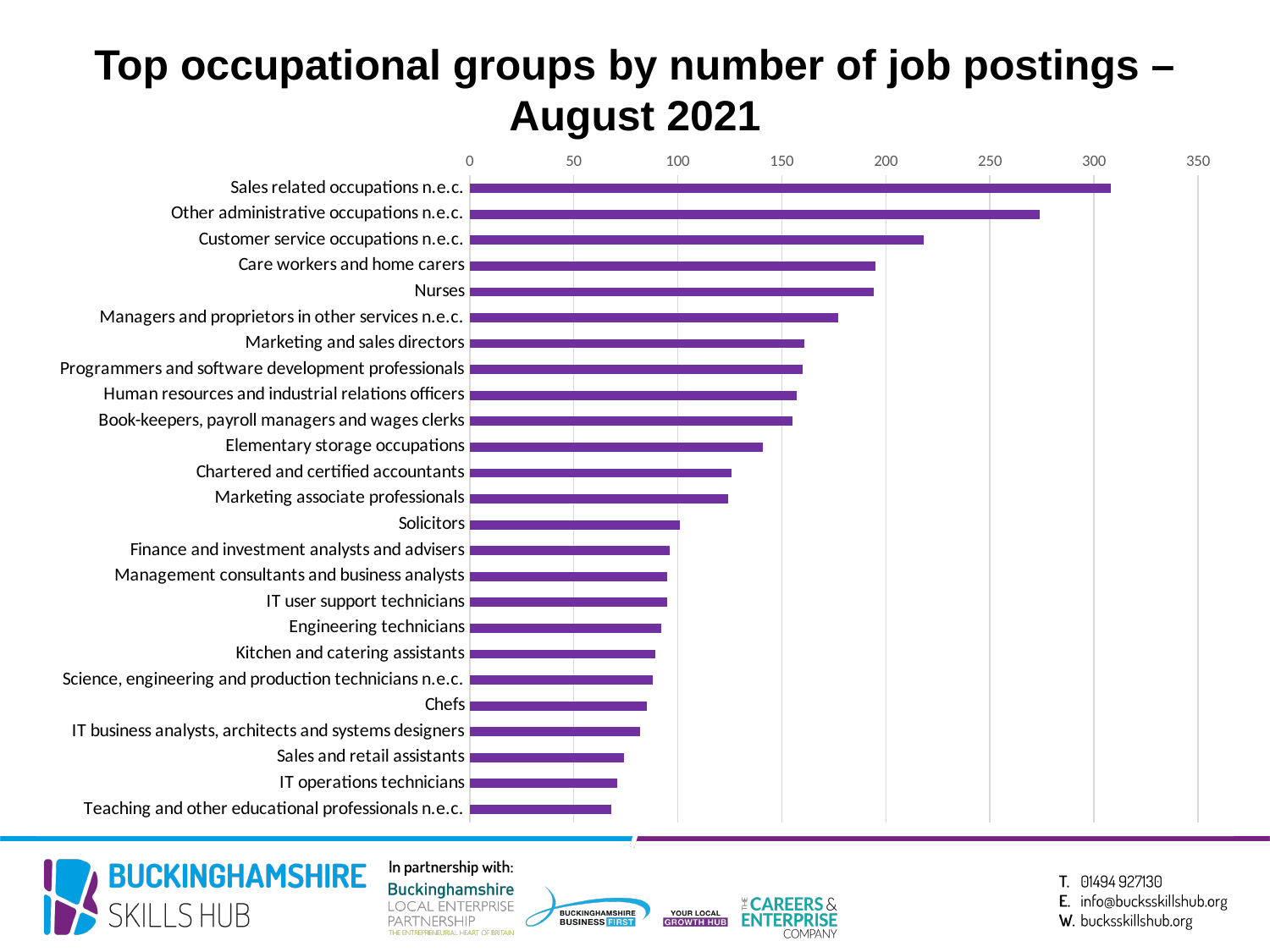
Which has more job postings: Customer service occupations n.e.c. or Nurses? Customer service occupations n.e.c. Which occupational group has the lowest number of job postings? Teaching and other educational professionals n.e.c. What kind of chart is shown on the slide? bar chart Is the value for Care workers and home carers greater or less than 200? less Which occupational group has the highest number of job postings? Sales related occupations n.e.c. Is the value for Other administrative occupations n.e.c. greater or less than 250? greater What is the title of the chart? Top occupational groups by number of job postings – August 2021 Is the value for Elementary storage occupations greater or less than 150? less Which has more job postings: Solicitors or Chefs? Solicitors How many occupational groups are shown in the chart? 25